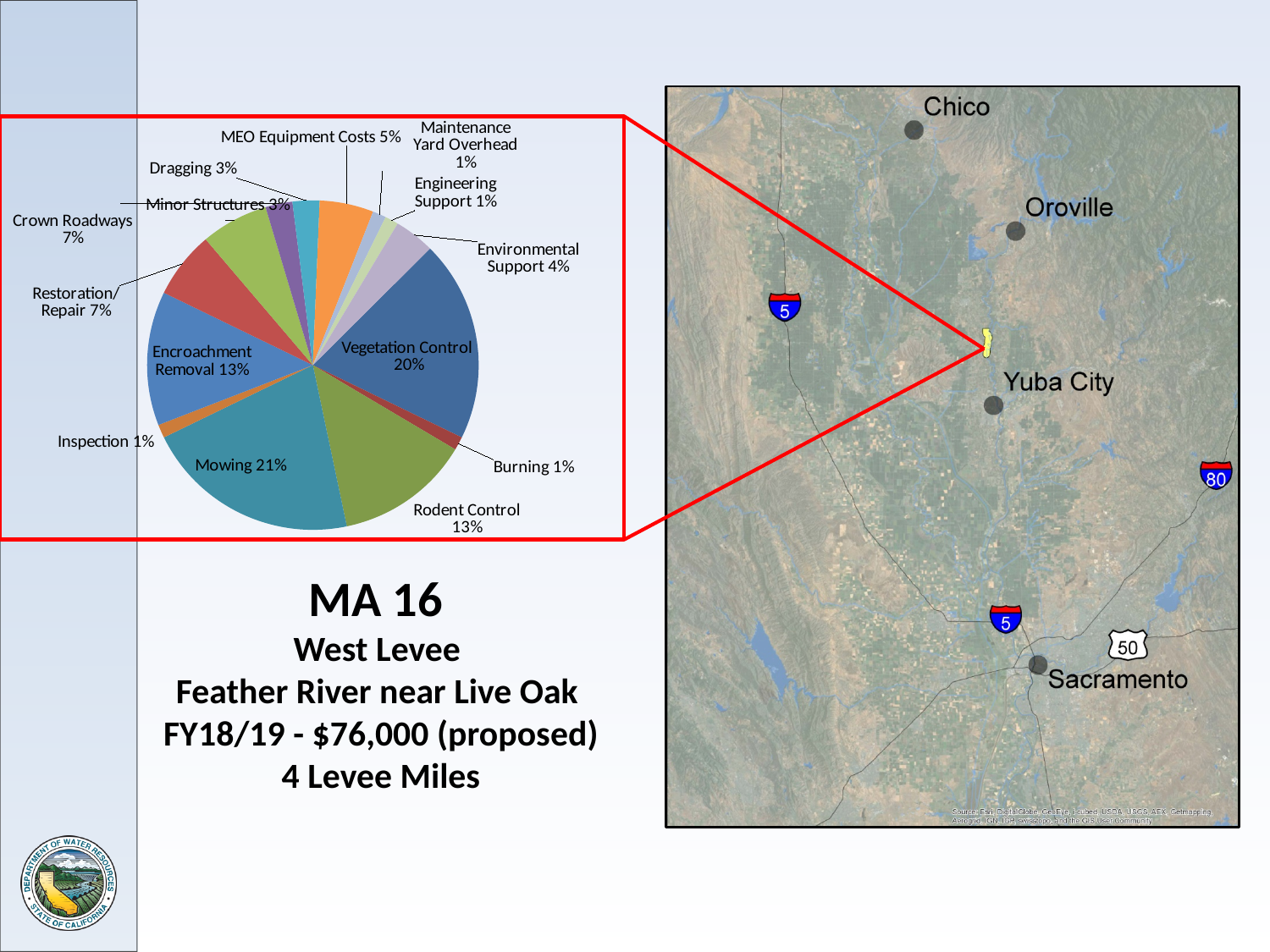
What percentage is shown for Encroachment Removal? 13% What share of the pie chart does Vegetation Control represent? 20% What is the difference in percentage points between Mowing and Rodent Control? 8 What percentage is labelled for MEO Equipment Costs? 5% How many categories are shown in the pie chart? 14 What percentage is shown for Mowing in the pie chart? 21% Which category has the largest share of the pie chart? Mowing What share does Environmental Support have in the pie chart? 4% Which has a larger share, Crown Roadways or Dragging? Crown Roadways What is the difference in percentage points between Vegetation Control and Environmental Support? 16 Which has a larger share, Vegetation Control or Restoration/Repair? Vegetation Control What type of chart is shown on the slide? Pie chart